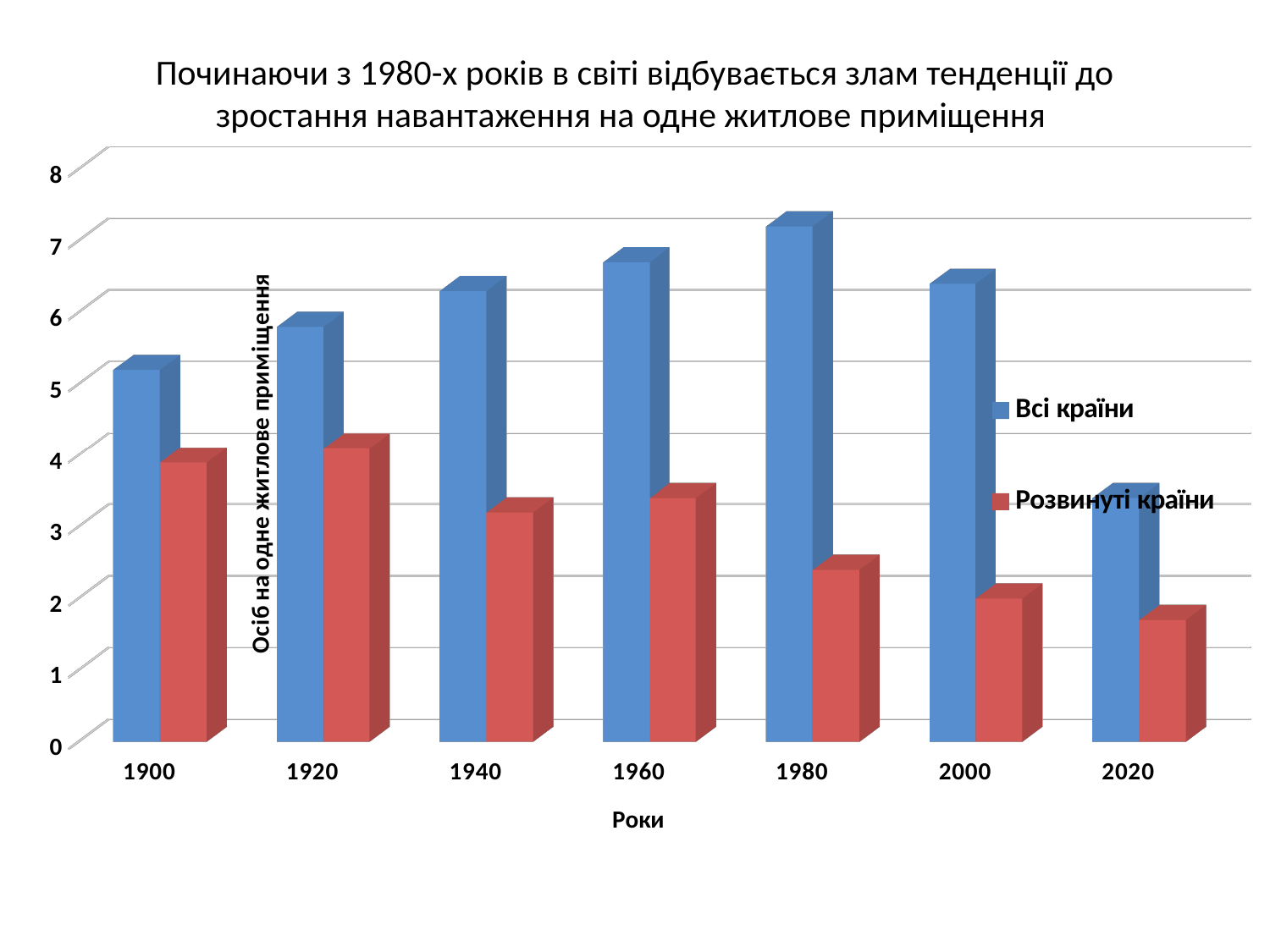
In which year is the value for Розвинуті країни lowest? 2020 Which is larger in 1960: the value for Всі країни or for Розвинуті країни? Всі країни What kind of chart is shown on the slide? Bar chart How many years are shown on the x axis? 7 How many series does the legend list? 2 Does the value for Розвинуті країни rise or fall from 1960 to 2020? Fall Is the value for Розвинуті країни in 1980 greater or less than 3? less Is the value for Всі країни in 1980 greater or less than 6? greater Is the value for Всі країни in 2020 greater or less than 4? less What is the title of the x axis? Роки In which year is the value for Всі країни highest? 1980 In which year is the value for Всі країни lowest? 2020